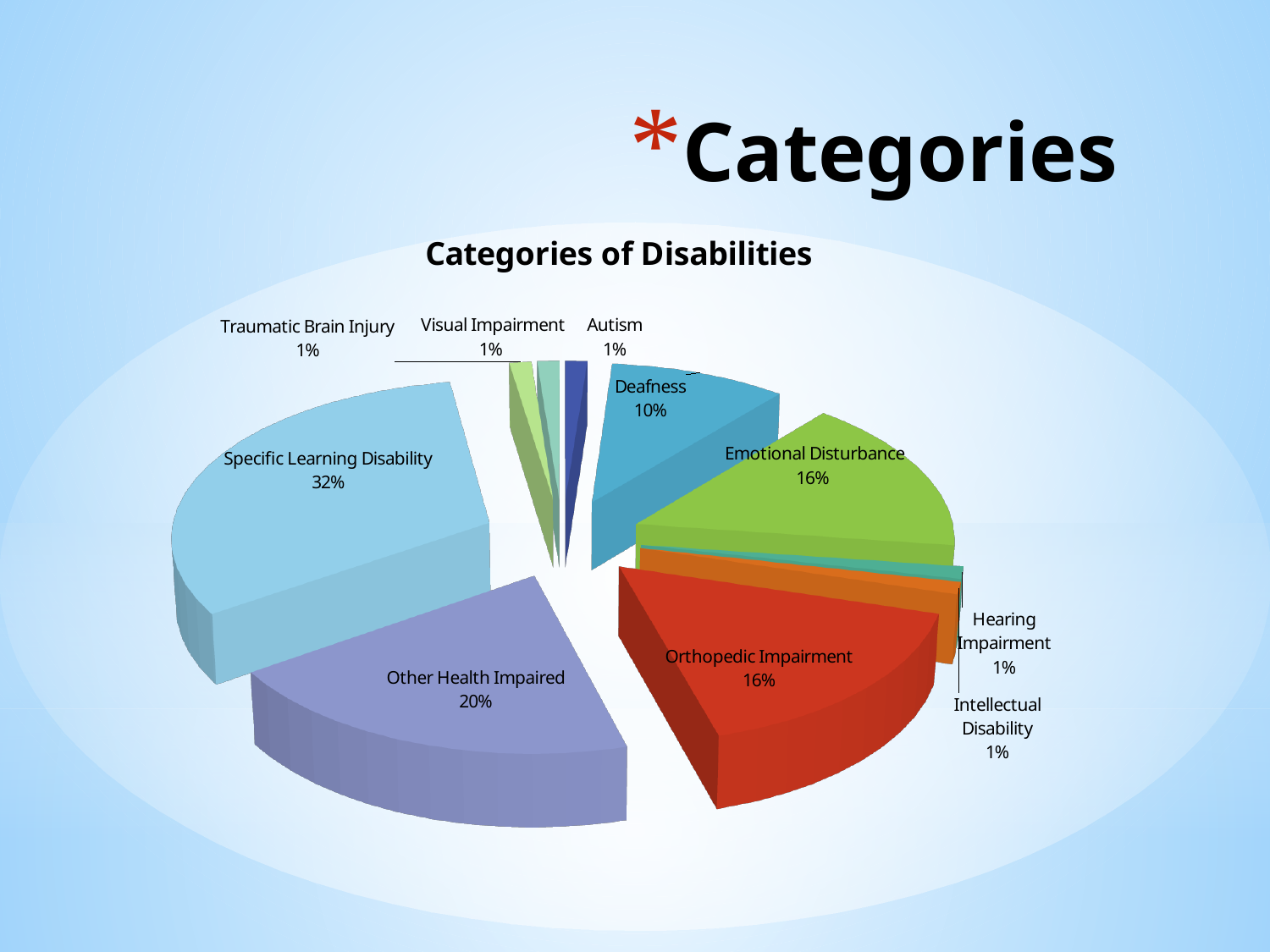
How many categories are shown in the pie chart? 10 What is the difference between the values for Other Health Impaired and Deafness? 10% What is the value shown for Emotional Disturbance? 16% Which category has the largest slice of the pie? Specific Learning Disability What is the value shown for Other Health Impaired? 20% What kind of chart is shown on the slide? pie chart What is the difference between the values for Specific Learning Disability and Other Health Impaired? 12% Which is larger, the value for Deafness or the value for Orthopedic Impairment? Orthopedic Impairment What share of the pie does Specific Learning Disability represent? 32% What is the value shown for Autism? 1% What is the title of the chart? Categories of Disabilities What is the value shown for Deafness? 10%